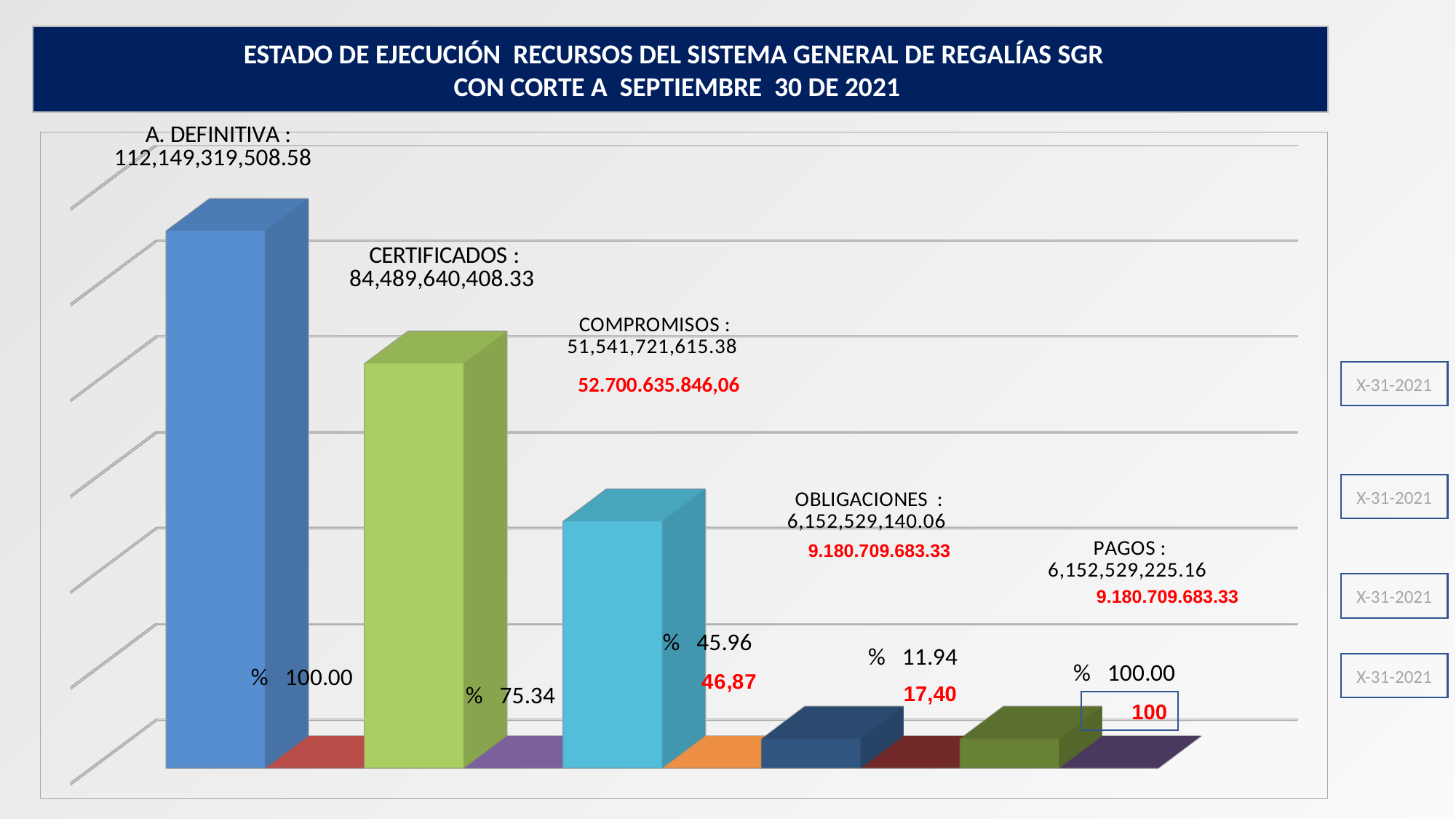
What percentage is printed in black for CERTIFICADOS? 75.34 Which category has the highest bar? A. DEFINITIVA What percentage is printed in black for OBLIGACIONES? 11.94 How many bars are shown in the chart? 5 What is the value printed in black for PAGOS? 6,152,529,225.16 What is the value for CERTIFICADOS? 84,489,640,408.33 What kind of chart is shown on the slide? Bar chart What percentage is printed in black for COMPROMISOS? 45.96 Which bar is taller, CERTIFICADOS or COMPROMISOS? CERTIFICADOS What is the value for A. DEFINITIVA? 112,149,319,508.58 What is the value printed in black for OBLIGACIONES? 6,152,529,140.06 What is the value printed in black for COMPROMISOS? 51,541,721,615.38